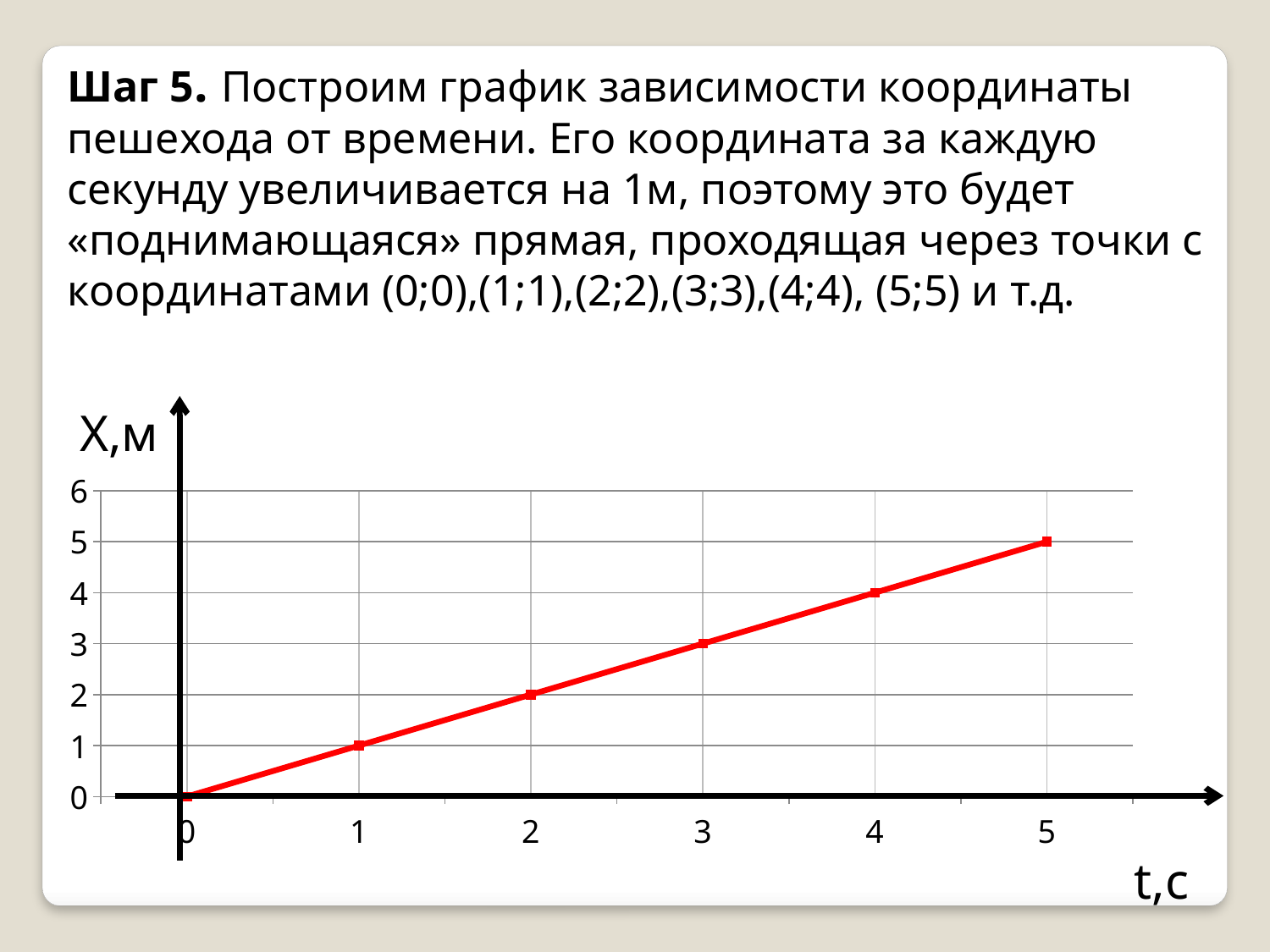
What kind of chart is shown on the slide? line chart What colour is the plotted line? red What is the value of X at t = 0 s? 0 At which value of t is X lowest? 0 How many data points are plotted on the line? 6 What is the value of X at t = 3 s? 3 Which is larger: X at t = 2 or X at t = 4? X at t = 4 Does X rise or fall as t increases? rises At which value of t is X highest? 5 What is the label of the vertical axis? X,м What is the difference between X at t = 4 and X at t = 1? 3 What is the value of X at t = 5 s? 5